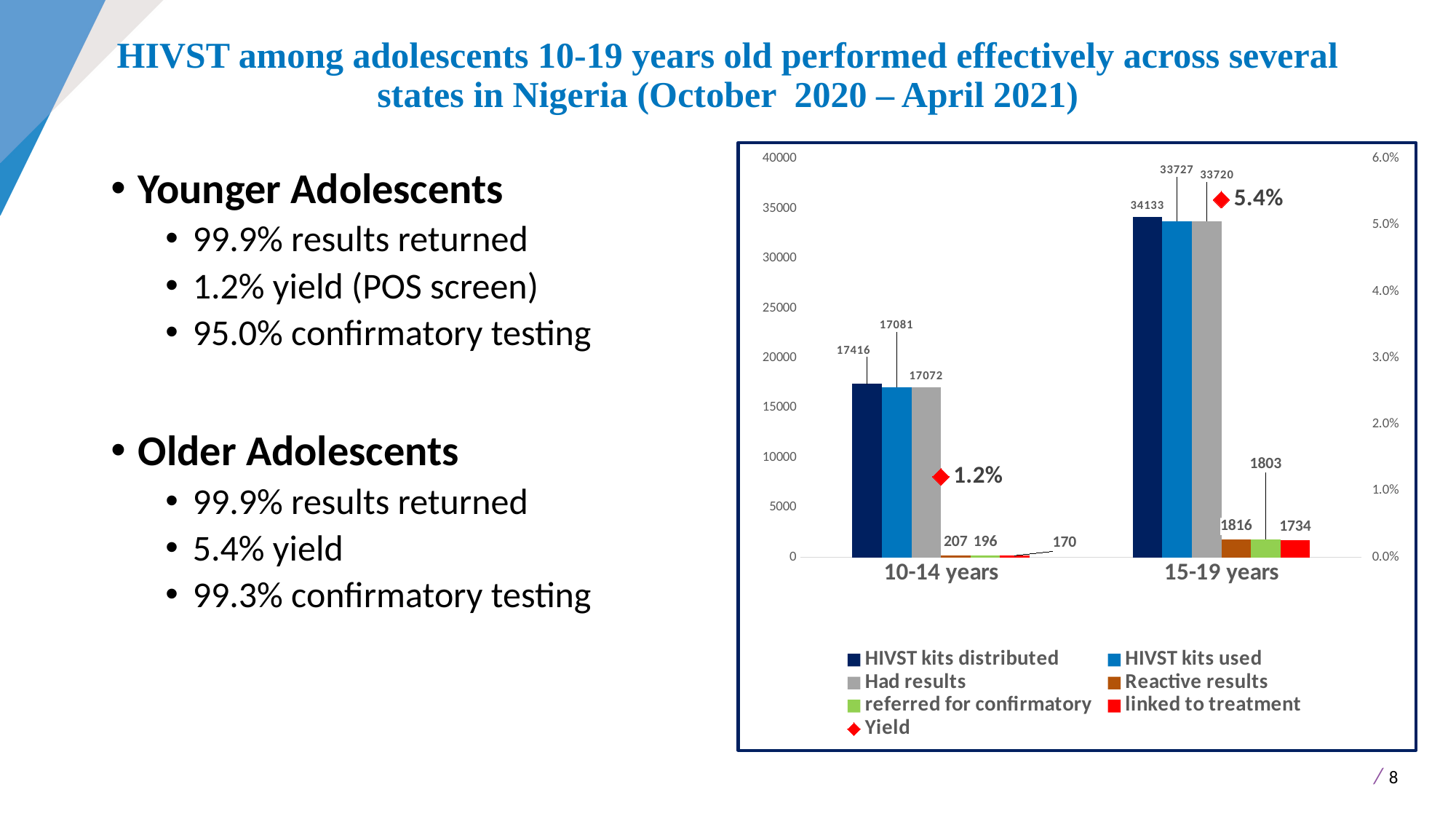
How many HIVST kits were used in the 15-19 years group? 33727 What is the Yield value for the 15-19 years group? 5.4% What type of chart is used to show the HIVST data? Bar chart What is the difference between HIVST kits distributed and HIVST kits used in the 10-14 years group? 335 How many adolescents aged 10-14 years were linked to treatment? 170 Which legend entry is shown with a red diamond marker? Yield How many HIVST kits were distributed to the 10-14 years group? 17416 Which age group had the higher number of HIVST kits distributed? 15-19 years What is the difference between the number referred for confirmatory and the number linked to treatment in the 15-19 years group? 69 How many reactive results were there in the 15-19 years group? 1816 How many series does the chart legend list? 7 How many age-group categories are shown on the x axis? 2